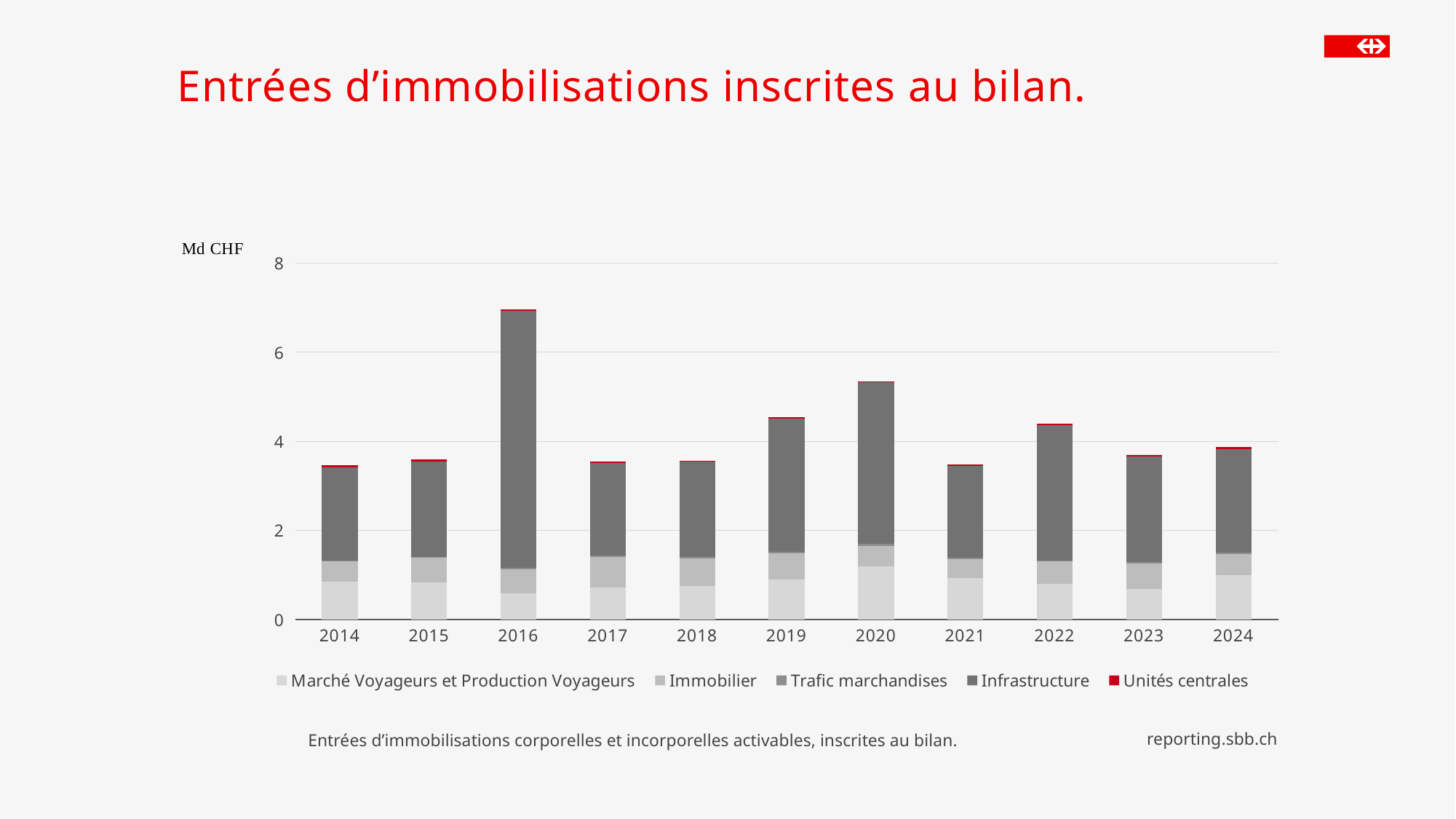
Which year has the highest total bar in the chart? 2016 How many series does the chart legend list? 5 Is the total value for 2020 greater or less than 4? greater Is the total value for 2018 greater or less than 4? less What unit is shown on the chart's value axis? Md CHF Which year has the larger total bar, 2022 or 2023? 2022 Is the total value for 2014 greater or less than 4? less How many years are shown on the x axis of the chart? 11 Which series in the legend is shown in red? Unités centrales What kind of chart is shown on the slide? Stacked bar chart